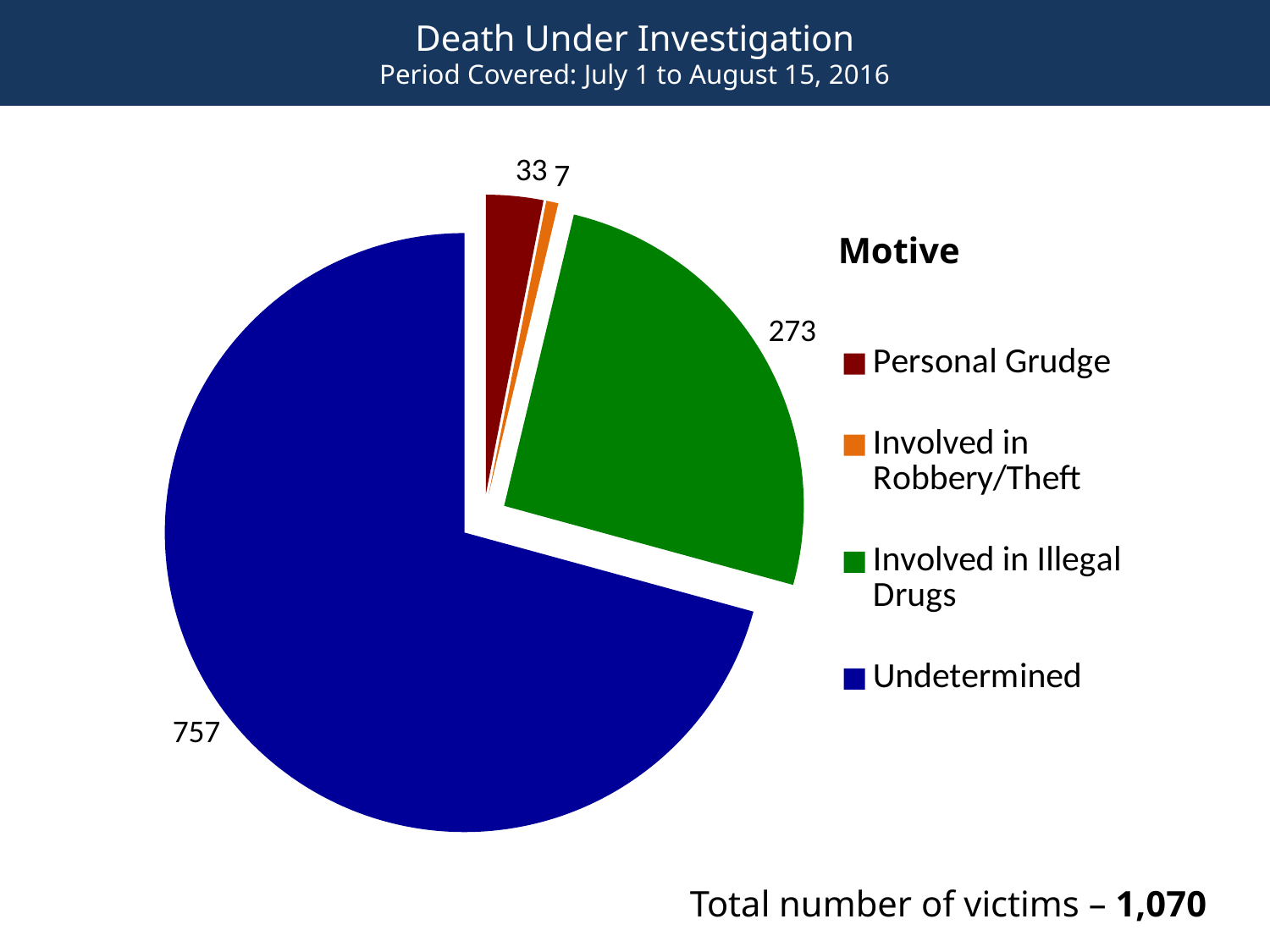
What is the difference between the Undetermined and Involved in Illegal Drugs values? 484 How many victims are in the Involved in Illegal Drugs category? 273 What is the total number of victims stated on the slide? 1,070 Which is larger, Personal Grudge or Involved in Robbery/Theft? Personal Grudge What is the title of the legend on the pie chart? Motive How many victims are in the Involved in Robbery/Theft category? 7 What kind of chart is shown on the slide? Pie chart Which motive category has the largest number of victims? Undetermined Which motive category has the smallest number of victims? Involved in Robbery/Theft How many motive categories does the legend list? 4 How many victims are in the Personal Grudge category? 33 How many victims are in the Undetermined category? 757